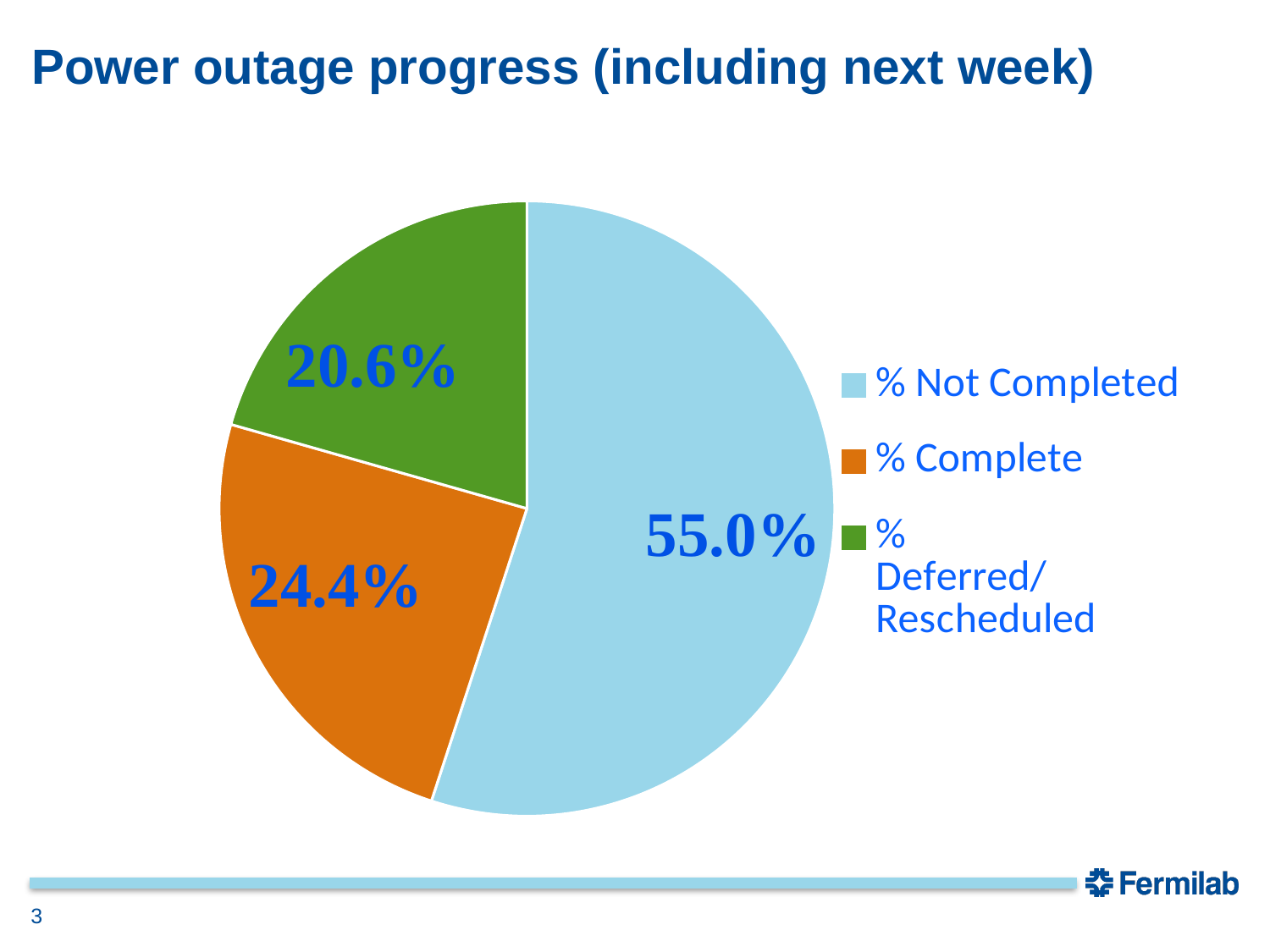
What colour is the % Complete slice? orange What is the difference between the % Complete slice and the % Deferred/Rescheduled slice? 3.8% Which category has the smallest slice of the pie? % Deferred/Rescheduled What is the value for % Deferred/Rescheduled? 20.6% What kind of chart is shown on the slide? pie chart What is the title of the slide containing the pie chart? Power outage progress (including next week) What is the value for % Complete? 24.4% Which category has the largest slice of the pie? % Not Completed What is the value for % Not Completed? 55.0% What is the difference between the % Not Completed slice and the % Complete slice? 30.6% Which is larger, the % Complete slice or the % Deferred/Rescheduled slice? % Complete How many slices does the pie chart have? 3